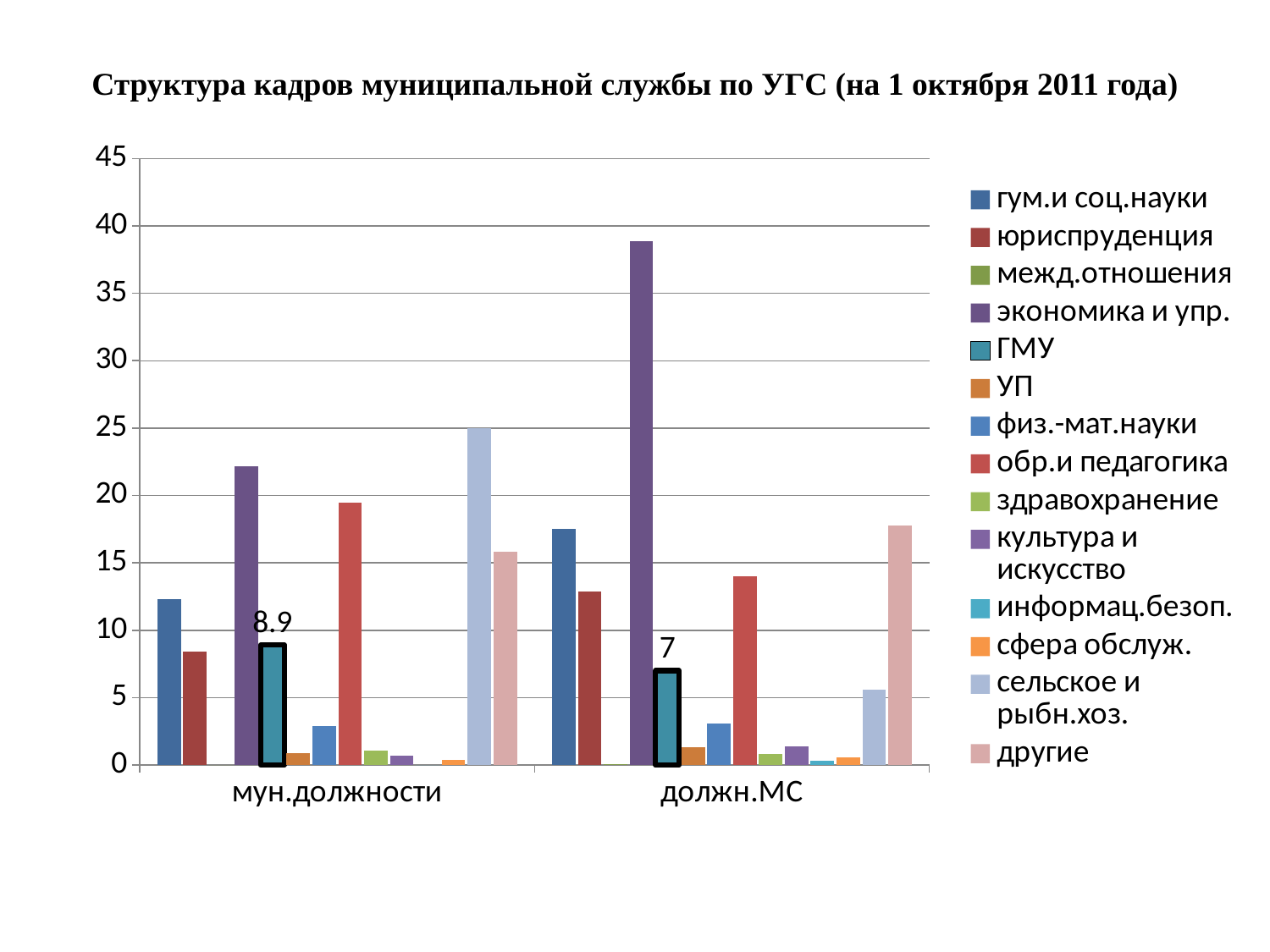
In which group is the value for гум.и соц.науки larger, мун.должности or должн.МС? должн.МС Is the value for экономика и упр. in the должн.МС group greater or less than 35? greater Is the value for обр.и педагогика in the мун.должности group greater or less than 15? greater What kind of chart is shown on the slide? bar chart What is the value for ГМУ in the мун.должности group? 8.9 How many categories are shown on the x axis? 2 What is the difference between the ГМУ values for мун.должности and должн.МС? 1.9 Which series has the highest bar in the мун.должности group? сельское и рыбн.хоз. Which series has the highest bar in the должн.МС group? экономика и упр. How many series does the legend list? 14 What is the value for ГМУ in the должн.МС group? 7 In which group is the ГМУ value larger, мун.должности or должн.МС? мун.должности